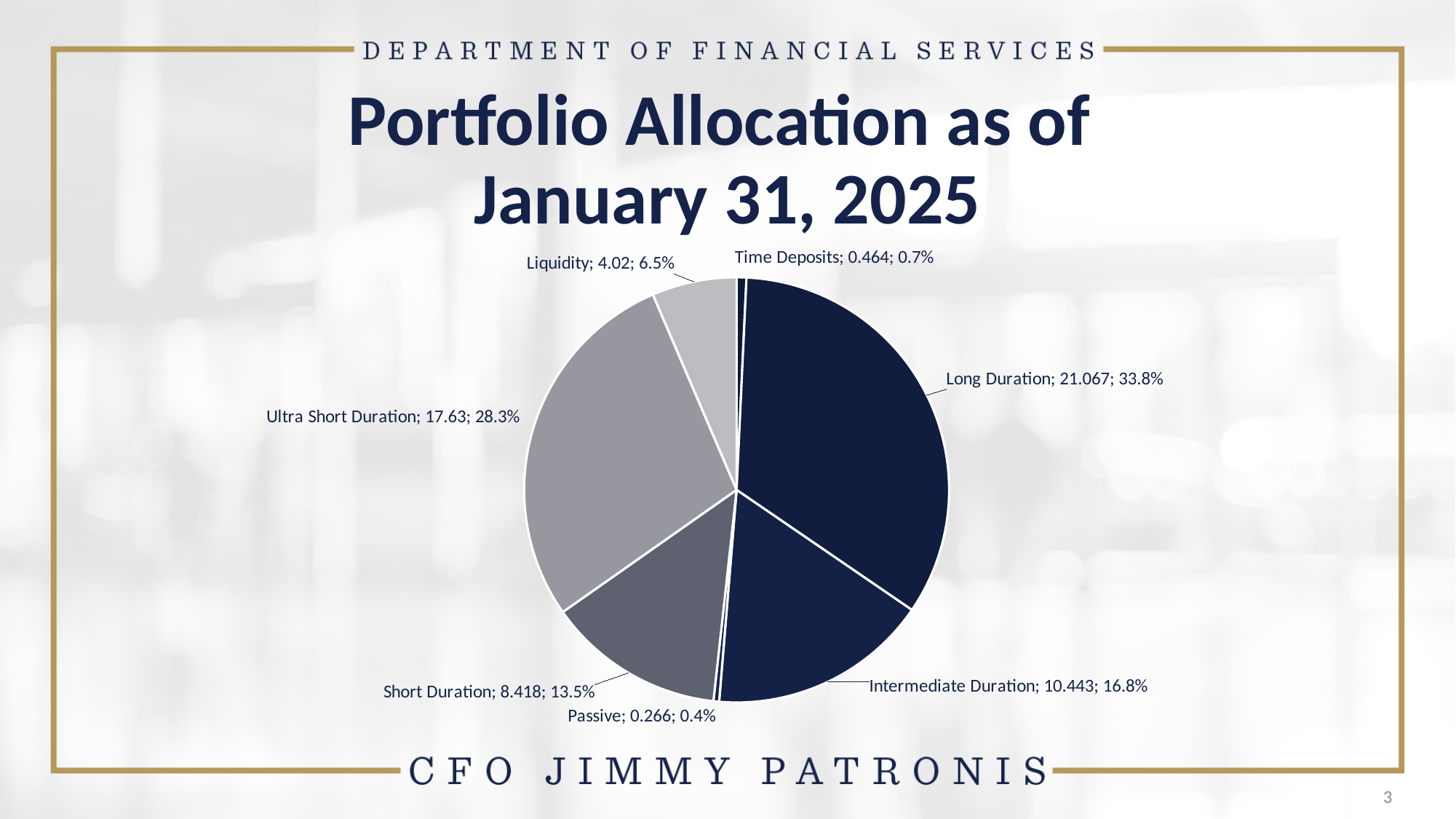
What is the value shown for Intermediate Duration? 10.443 What is the value shown for Long Duration? 21.067 What is the title of the chart on the slide? Portfolio Allocation as of January 31, 2025 Which is larger, Short Duration or Intermediate Duration? Intermediate Duration Which category has the largest slice of the pie? Long Duration What kind of chart is shown on the slide? Pie chart What is the difference in value between Long Duration and Ultra Short Duration? 3.437 What is the value shown for Time Deposits? 0.464 Which category has the smallest slice of the pie? Passive What percentage share does Liquidity have? 6.5% How many categories are shown in the pie chart? 7 What percentage share does Ultra Short Duration have? 28.3%